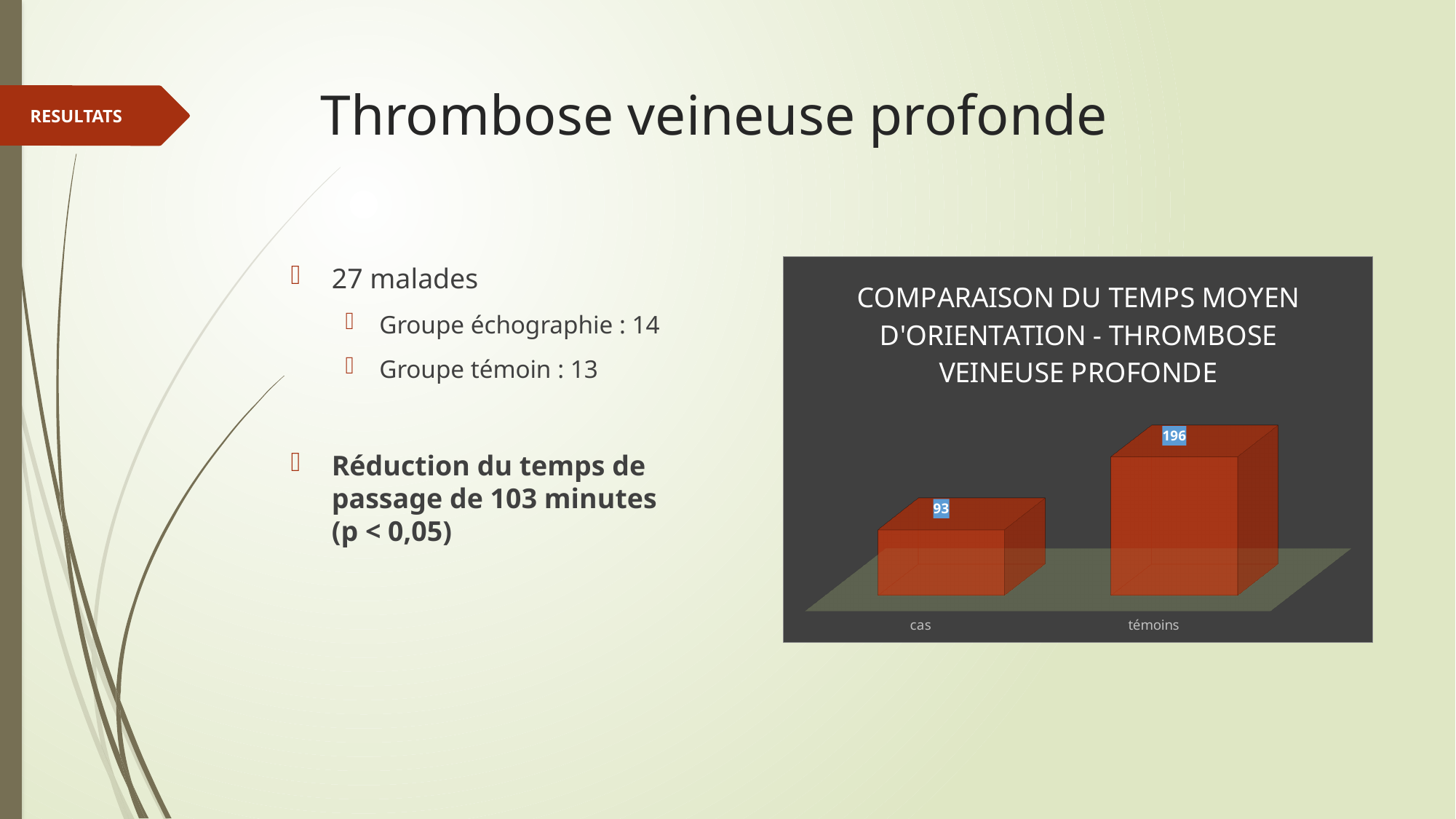
What colour are the bars in the chart? red What is the title of the chart? COMPARAISON DU TEMPS MOYEN D'ORIENTATION - THROMBOSE VEINEUSE PROFONDE Which category has the highest value in the chart? témoins What kind of chart is shown on the slide? bar chart What is the value for "cas" in the chart? 93 How many categories are shown in the chart? 2 What is the difference between the values for "témoins" and "cas"? 103 What is the value for "témoins" in the chart? 196 Do the values rise or fall from "cas" to "témoins"? rise Which category has the lowest value in the chart? cas Which is larger, the value for "cas" or the value for "témoins"? témoins